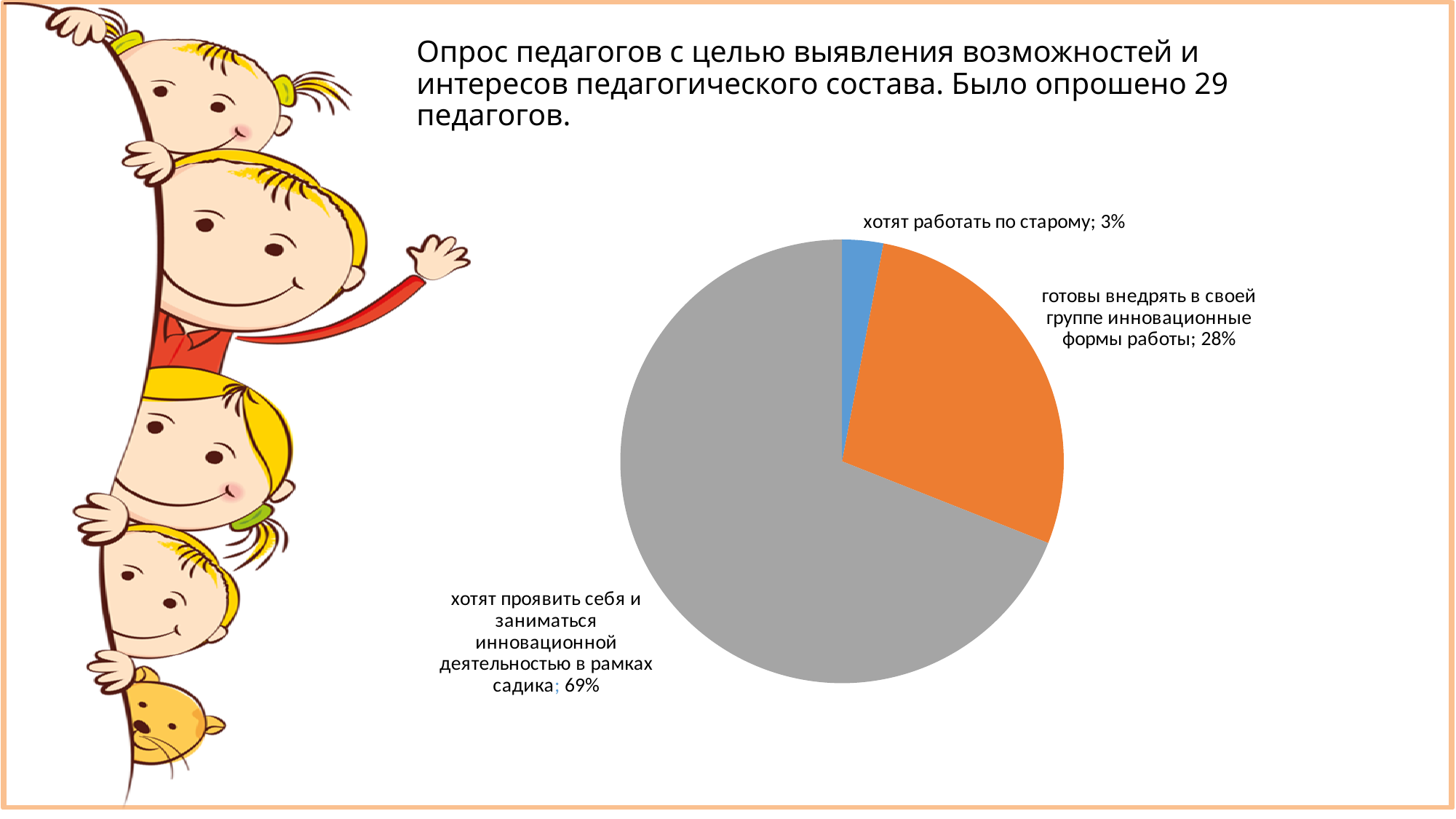
Which is larger: the slice for "готовы внедрять в своей группе инновационные формы работы" or the slice for "хотят работать по старому"? готовы внедрять в своей группе инновационные формы работы What is the difference in percentage points between the "хотят проявить себя" slice (69%) and the "готовы внедрять" slice (28%)? 41 What share of the pie is labelled "готовы внедрять в своей группе инновационные формы работы"? 28% What share of the pie is labelled "хотят работать по старому"? 3% What colour is the slice for "хотят работать по старому"? blue What share of the pie is labelled "хотят проявить себя и заниматься инновационной деятельностью в рамках садика"? 69% How many slices does the pie chart have? 3 What kind of chart is shown on the slide? pie chart Which category has the smallest slice of the pie? хотят работать по старому Which category has the largest slice of the pie? хотят проявить себя и заниматься инновационной деятельностью в рамках садика According to the slide text, how many teachers were surveyed? 29